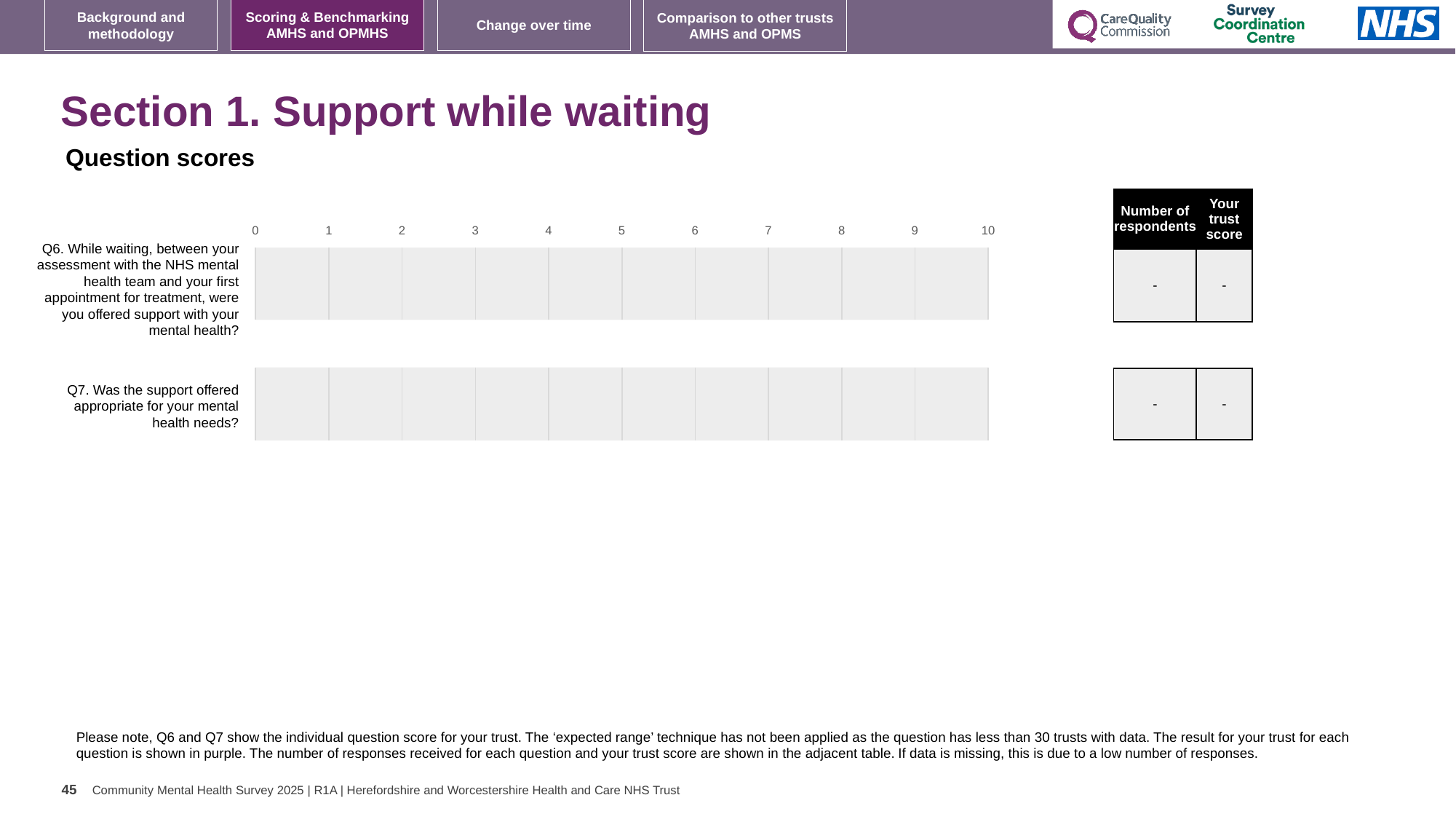
What is the 'Your trust score' shown for Q6 in the adjacent table? - What is the highest value shown on the chart's axis? 10 What kind of chart is used to show the question scores? bar chart What is the 'Your trust score' shown for Q7 in the adjacent table? - What is the lowest value shown on the chart's axis? 0 What is the 'Number of respondents' shown for Q7 in the adjacent table? - How many questions (categories) are plotted on the chart? 2 What is the 'Number of respondents' shown for Q6 in the adjacent table? -